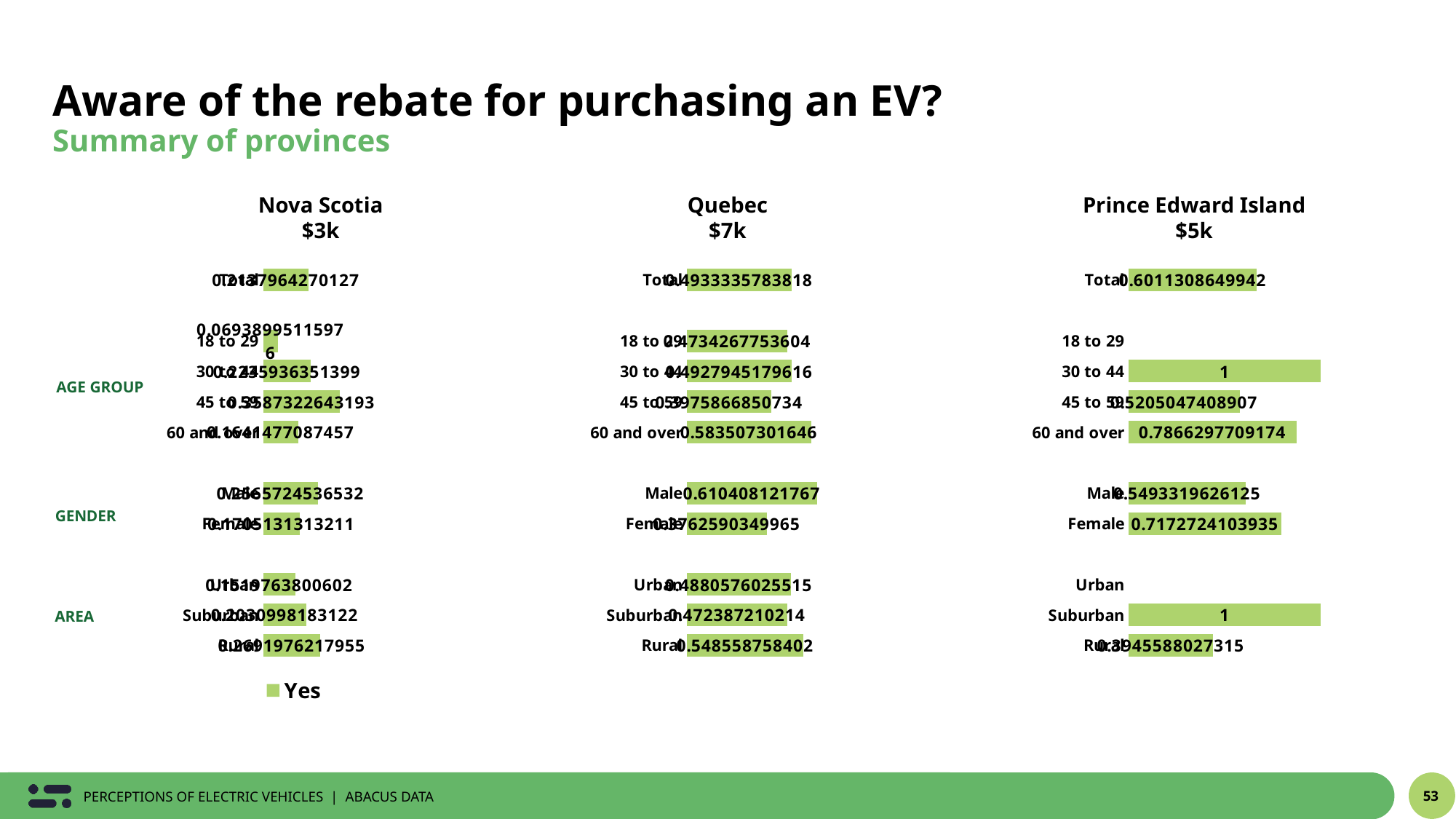
In the Quebec $7k chart, which is larger, Male or Female? Male In the Prince Edward Island $5k chart, what is the value for 30 to 44? 1 In the Prince Edward Island $5k chart, what is the value for 60 and over? 0.7866297709174 In the Prince Edward Island $5k chart, which is larger, Male or Female? Female In the Prince Edward Island $5k chart, what is the value for Suburban? 1 What kind of chart is used for the Nova Scotia $3k panel? bar chart In the Prince Edward Island $5k chart, what is the value for Female? 0.7172724103935 In the Quebec $7k chart, what is the value for Male? 0.610408121767 How many series does the legend list? 1 Which province's chart is labelled with the $7k rebate? Quebec In the Quebec $7k chart, what is the value for 60 and over? 0.583507301646 In the Prince Edward Island $5k chart, what is the difference between the values for 30 to 44 and 60 and over? 0.2133702290826